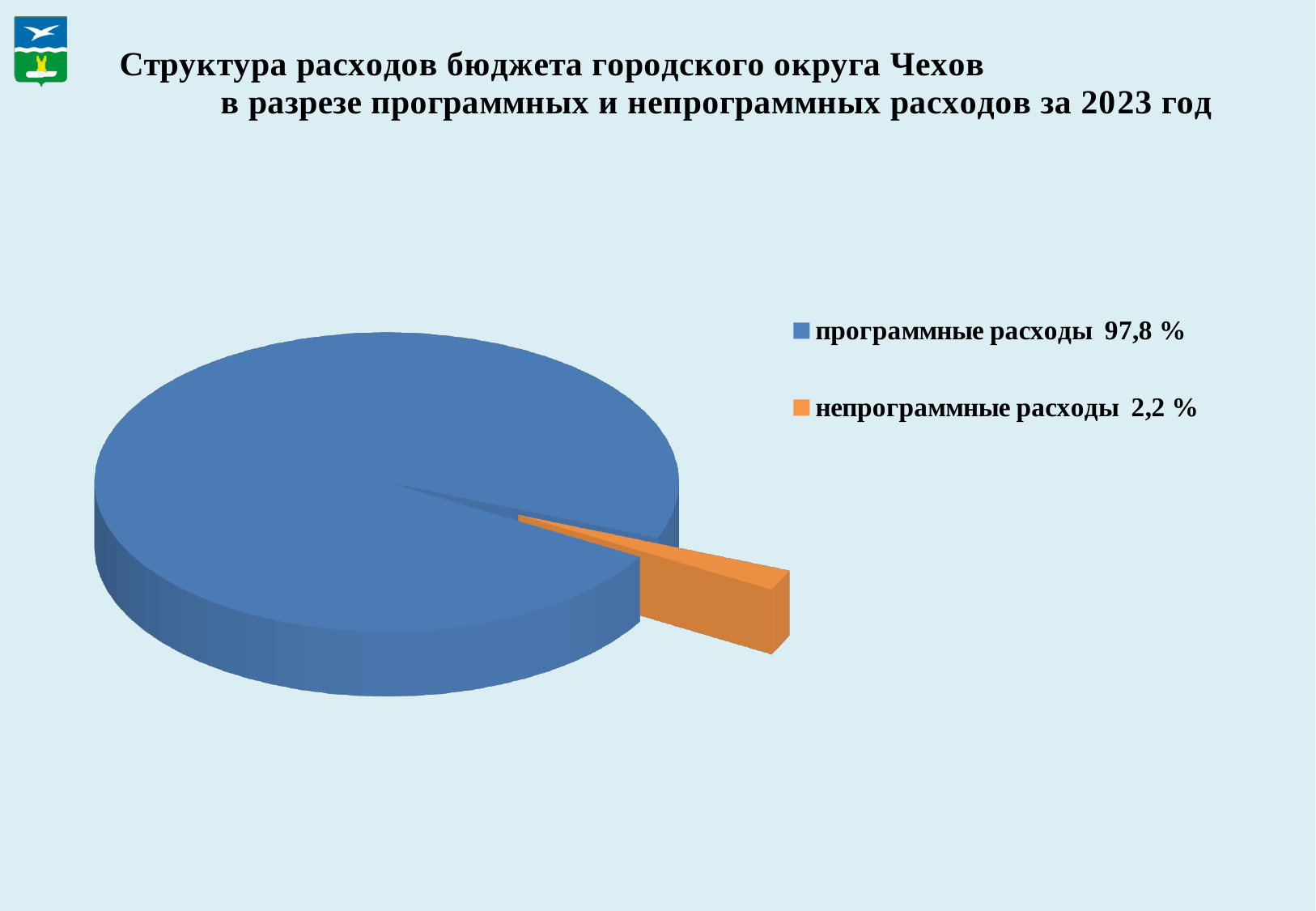
What colour is the slice for "программные расходы"? blue How many slices does the pie chart have? 2 Which category has the smallest slice of the pie? непрограммные расходы What kind of chart is shown on the slide? pie chart Which category has the largest slice of the pie? программные расходы How many entries does the legend list? 2 What colour is the slice for "непрограммные расходы"? orange What is the difference in percentage points between "программные расходы" and "непрограммные расходы"? 95,6 Which is larger, "программные расходы" or "непрограммные расходы"? программные расходы What share of the pie is "программные расходы"? 97,8 % What share of the pie is "непрограммные расходы"? 2,2 %